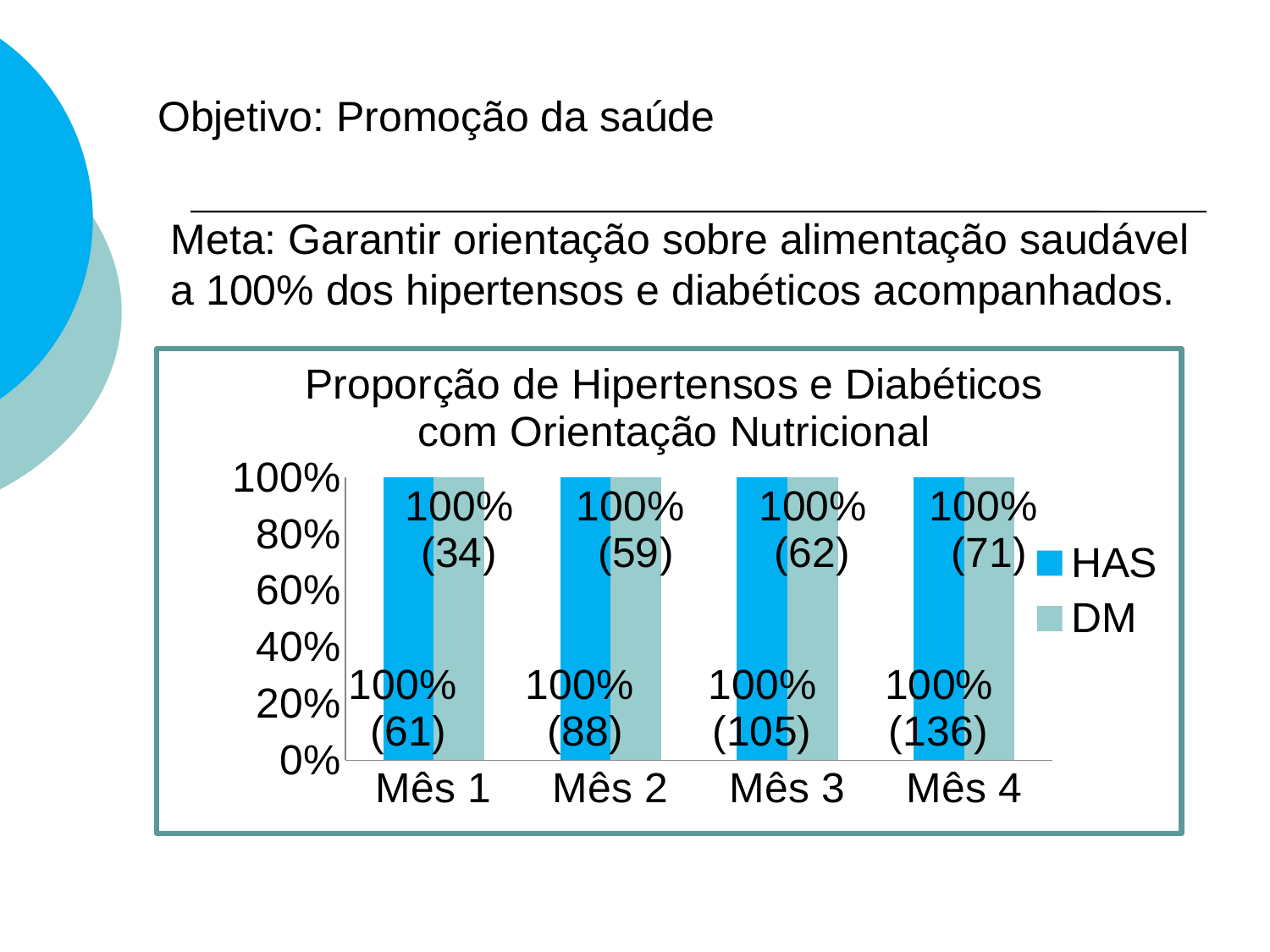
What is the difference between the number in parentheses for HAS in Mês 4 and HAS in Mês 1? 75 What kind of chart is shown on the slide? Bar chart What number is shown in parentheses for the HAS bar in Mês 3? 105 What is the title of the chart? Proporção de Hipertensos e Diabéticos com Orientação Nutricional What is the HAS value for Mês 1? 100% Is the DM value for Mês 4 greater or less than 80%? greater What number is shown in parentheses for the HAS bar in Mês 4? 136 What number is shown in parentheses for the DM bar in Mês 2? 59 Do the HAS values rise, fall or stay the same from Mês 1 to Mês 4? Stay the same What is the DM value for Mês 3? 100% How many categories (months) are shown on the x axis? 4 How many series does the legend list? 2